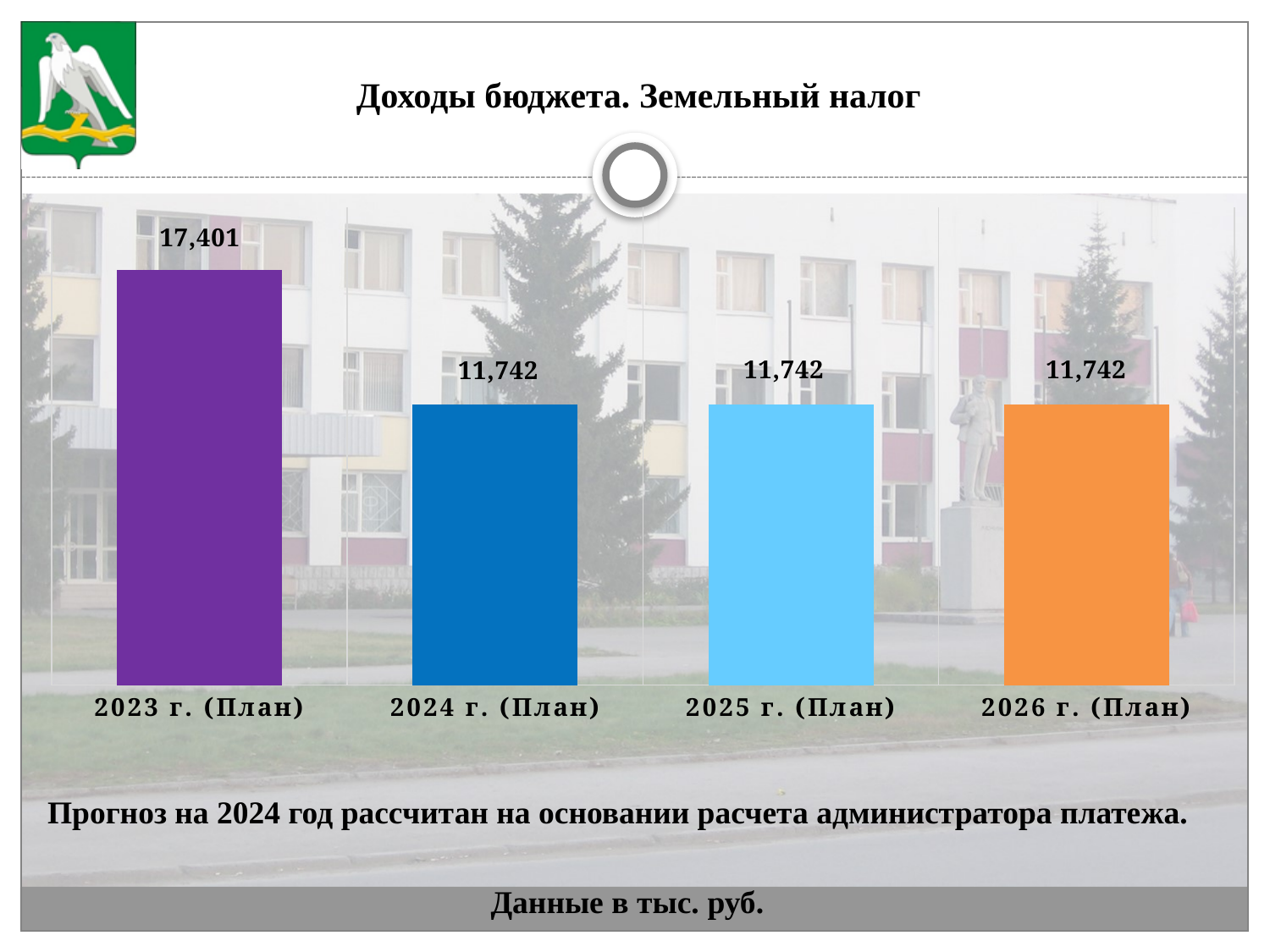
Which is larger, the value for 2023 г. (План) or the value for 2025 г. (План)? 2023 г. (План) In what units are the data on the chart given? тыс. руб. What is the difference between the values for 2023 г. (План) and 2024 г. (План)? 5,659 What is the value for 2024 г. (План)? 11,742 How many categories are shown on the chart? 4 What is the value for 2026 г. (План)? 11,742 Do the values rise or fall from 2023 г. (План) to 2024 г. (План)? Fall Are the values for 2024, 2025 and 2026 (План) the same or different? The same What kind of chart is shown on the slide? Bar chart What is the value for 2023 г. (План)? 17,401 What is the title of the chart? Доходы бюджета. Земельный налог Which category has the highest value? 2023 г. (План)